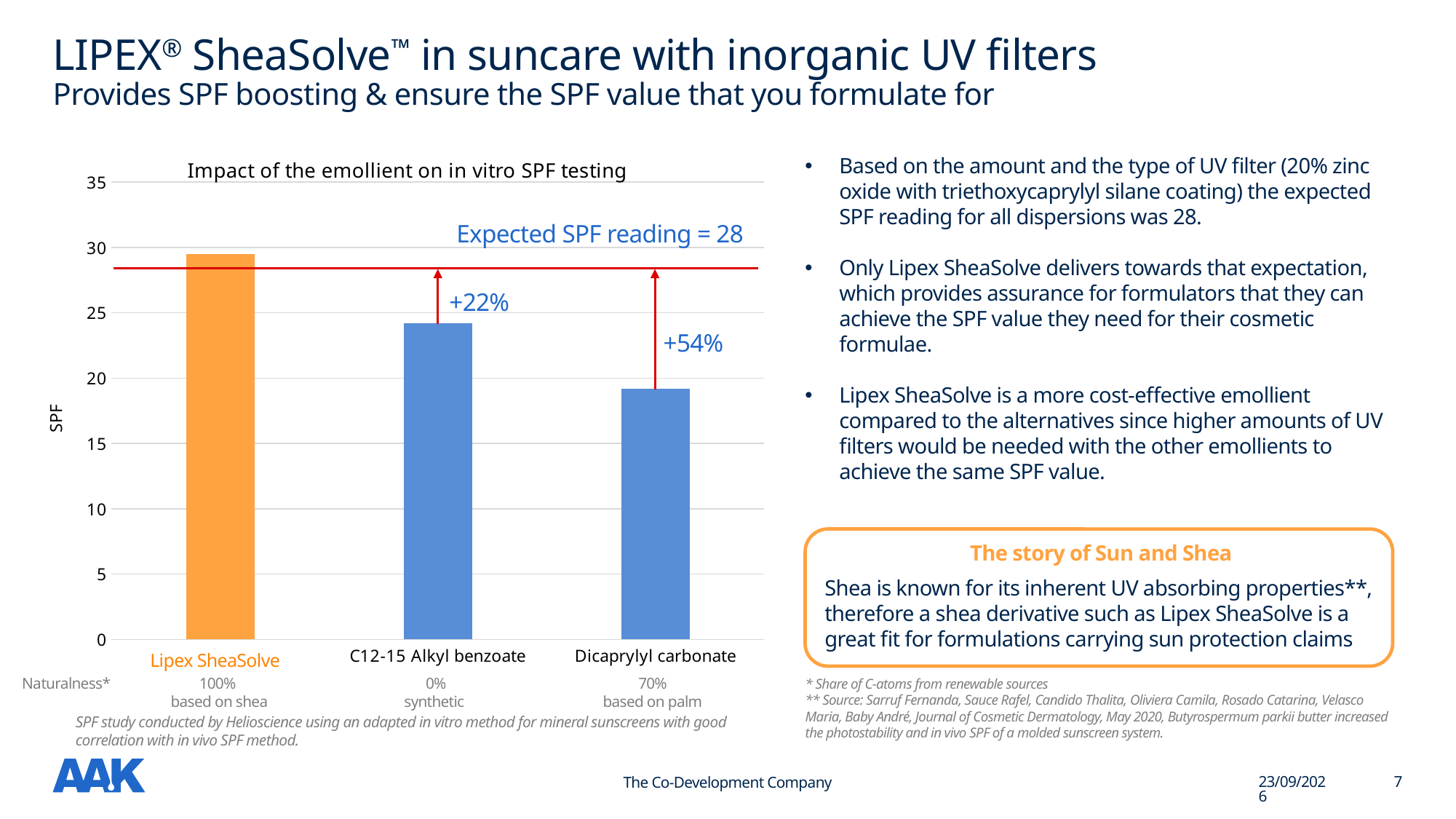
Which has a higher SPF value, C12-15 Alkyl benzoate or Dicaprylyl carbonate? C12-15 Alkyl benzoate What expected SPF reading is marked by the horizontal red line on the chart? 28 What percentage increase is annotated above the C12-15 Alkyl benzoate bar? +22% Is the SPF value for Dicaprylyl carbonate greater or less than 25? less Is the SPF value for C12-15 Alkyl benzoate greater or less than 20? greater What kind of chart is shown on the slide? Bar chart What is the title of the chart? Impact of the emollient on in vitro SPF testing What percentage increase is annotated above the Dicaprylyl carbonate bar? +54% Is the SPF value for Lipex SheaSolve greater or less than 25? greater Which emollient has the lowest in vitro SPF value? Dicaprylyl carbonate How many emollients (bars) are plotted in the chart? 3 Which emollient has the highest in vitro SPF value? Lipex SheaSolve